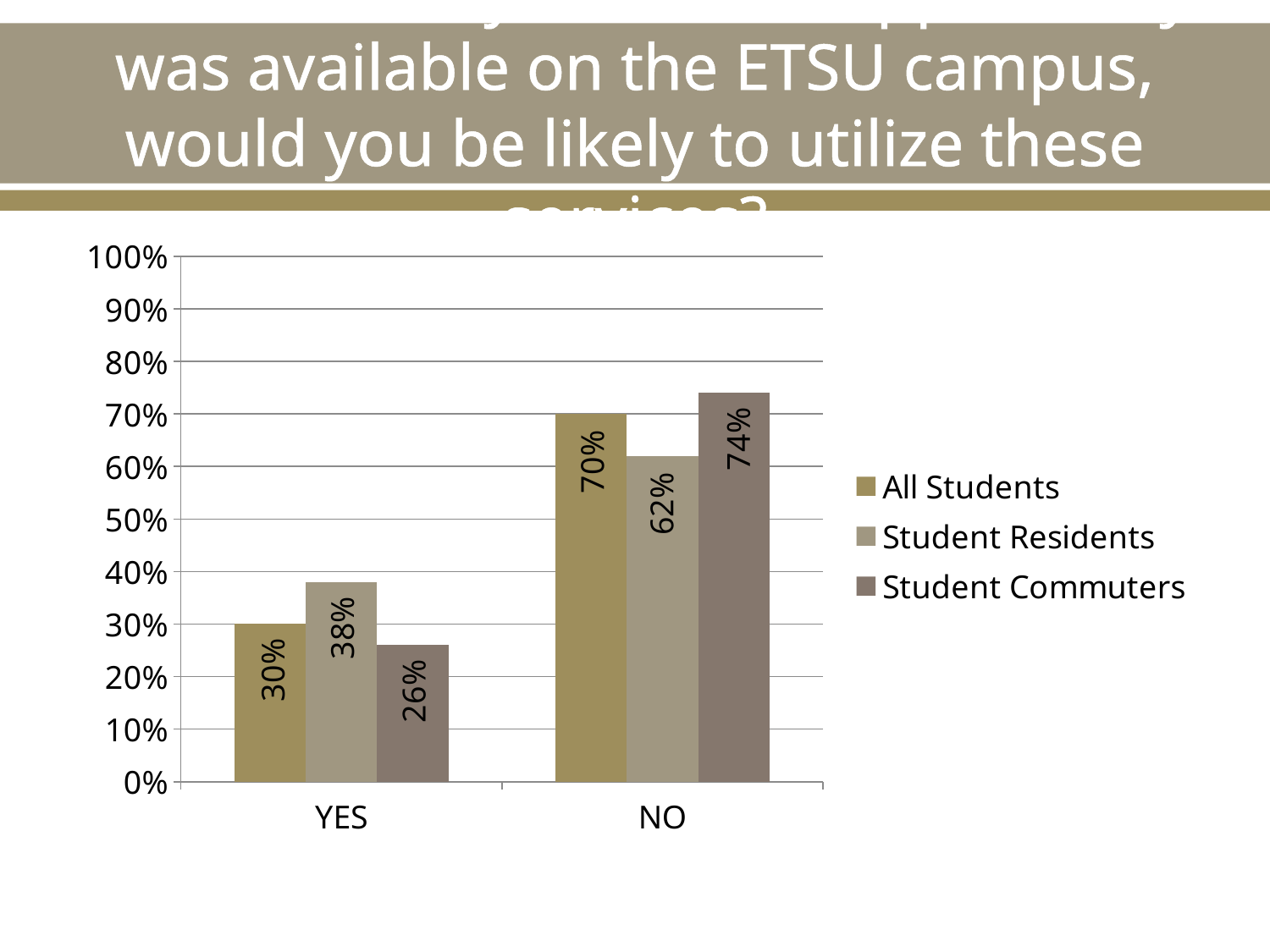
Which series has the highest value for NO? Student Commuters Which series has the lowest value for YES? Student Commuters What percentage of Student Commuters answered NO? 74% Which is larger: the All Students value for NO or the Student Residents value for NO? All Students What kind of chart is shown on the slide? Bar chart How many series does the legend list? 3 What is the difference between the Student Residents and All Students values for YES? 8% What percentage of Student Residents answered NO? 62% What percentage of Student Commuters answered YES? 26% How many categories are shown on the x axis? 2 Is the Student Residents value for YES greater or less than 40%? less What percentage of All Students answered YES? 30%